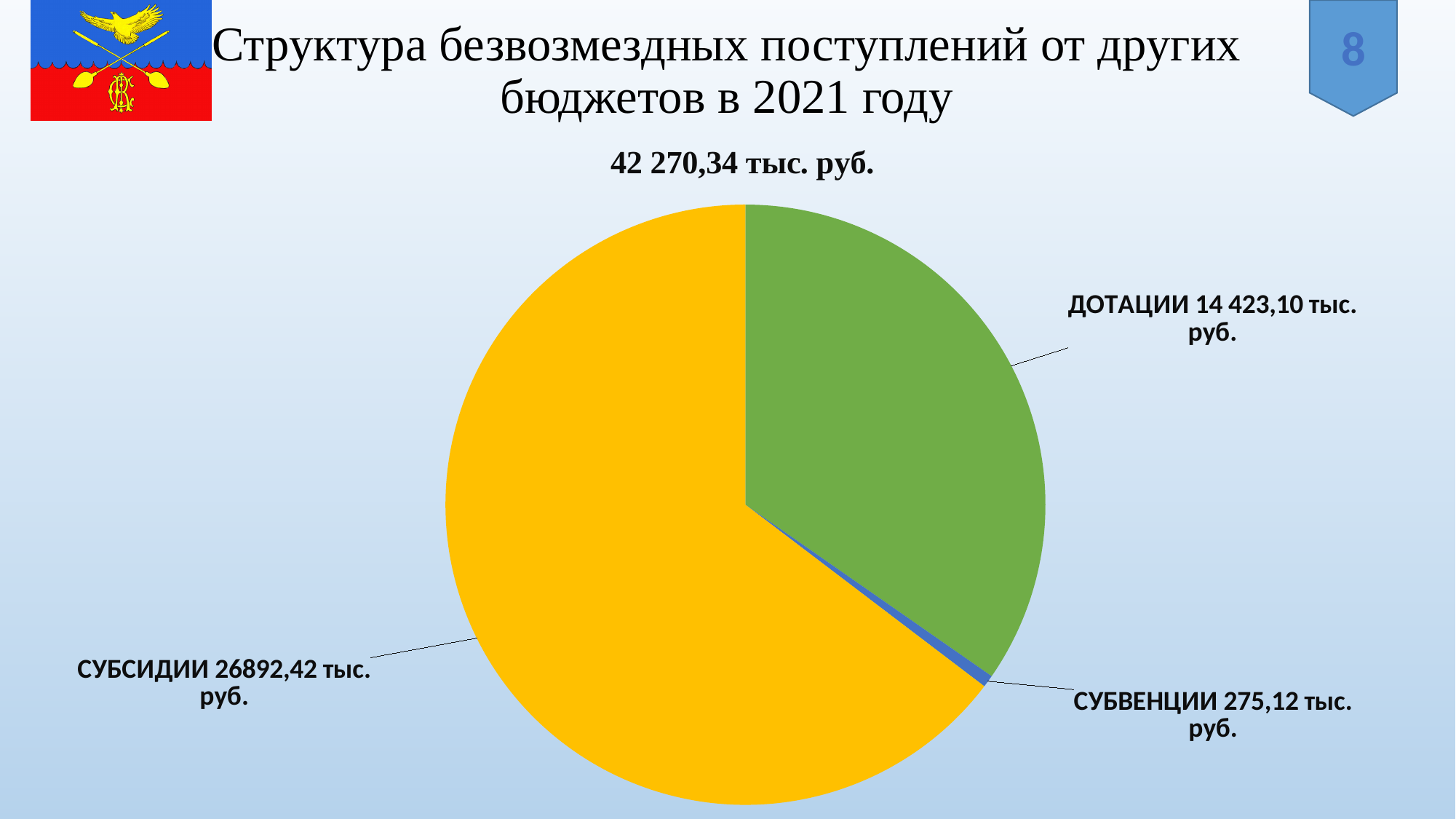
How many slices does the pie chart have? 3 Which category has the smallest slice of the pie? СУБВЕНЦИИ What is the value for СУБСИДИИ? 26892,42 тыс. руб. What is the value for ДОТАЦИИ? 14 423,10 тыс. руб. What is the value for СУБВЕНЦИИ? 275,12 тыс. руб. What year does the chart title refer to? 2021 What kind of chart is shown on the slide? Pie chart What is the difference between СУБСИДИИ and ДОТАЦИИ? 12 469,32 тыс. руб. Which is larger, ДОТАЦИИ or СУБВЕНЦИИ? ДОТАЦИИ What total amount is printed above the pie chart? 42 270,34 тыс. руб. What colour is the СУБСИДИИ slice? Yellow Which category has the largest slice of the pie? СУБСИДИИ